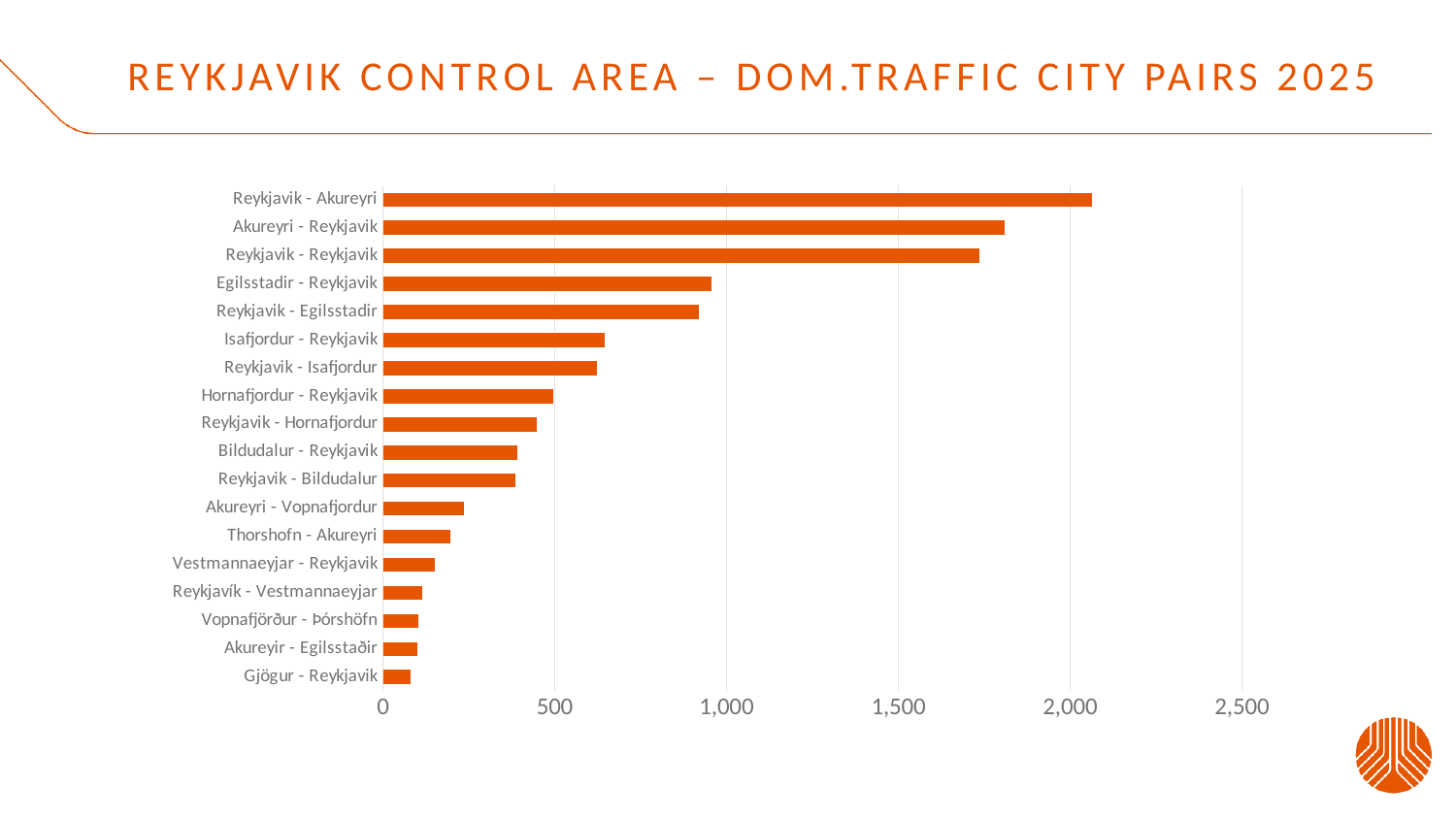
What kind of chart is shown on the slide? bar chart Is the value for Akureyri - Reykjavik greater or less than 2,000? less Is the value for Reykjavik - Hornafjordur greater or less than 500? less Is the value for Reykjavik - Reykjavik greater or less than 1,500? greater Which city pair has the highest value in the chart? Reykjavik - Akureyri Which is larger, the value for Reykjavik - Akureyri or the value for Akureyri - Reykjavik? Reykjavik - Akureyri What is the title of the slide? REYKJAVIK CONTROL AREA – DOM.TRAFFIC CITY PAIRS 2025 How many city pairs are plotted in the chart? 18 What is the highest value shown on the horizontal axis of the chart? 2,500 Which is larger, the value for Reykjavik - Reykjavik or the value for Egilsstadir - Reykjavik? Reykjavik - Reykjavik